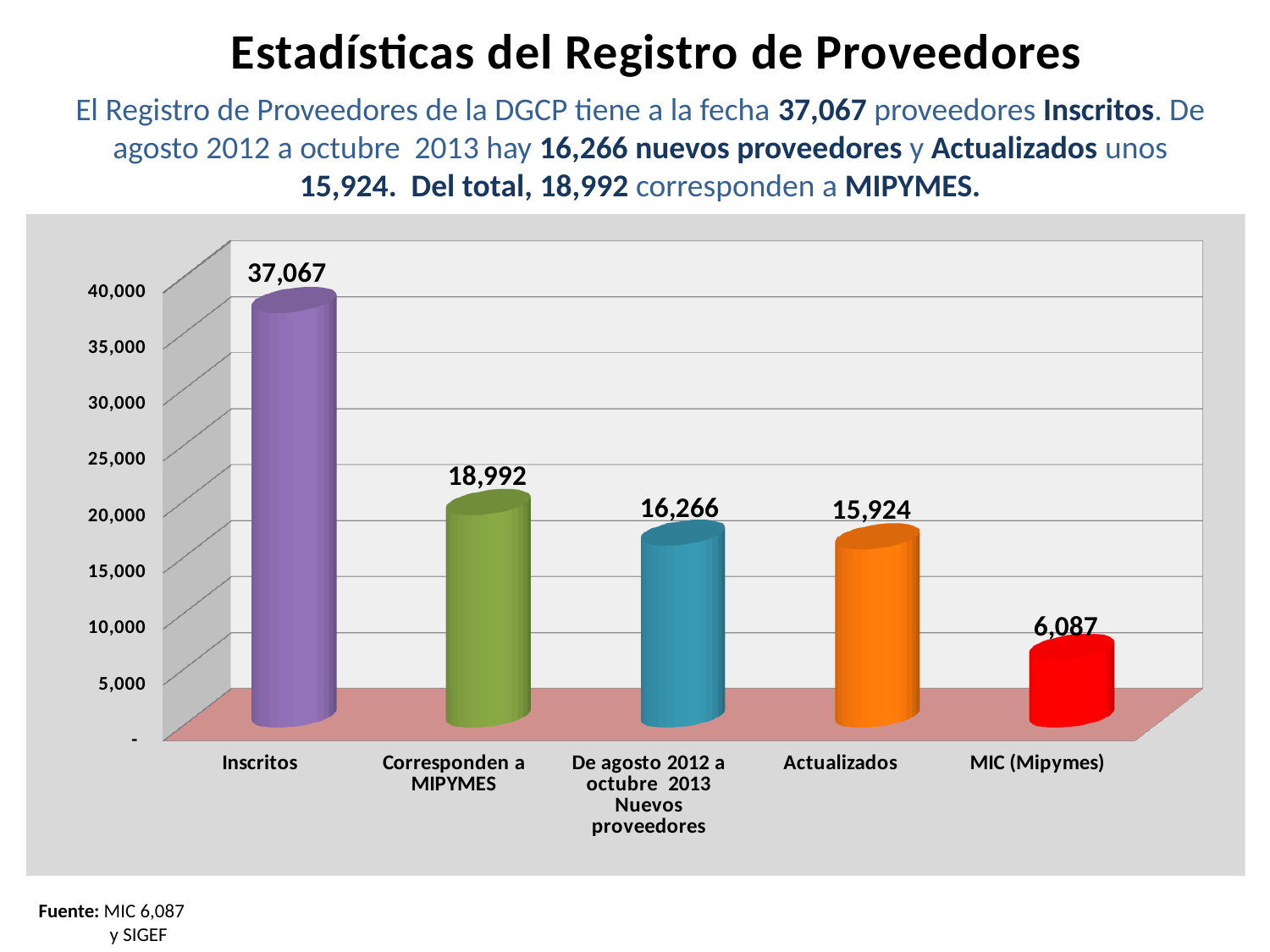
What kind of chart is shown on the slide? Bar chart How many categories are shown in the chart? 5 Which category has the lowest value? MIC (Mipymes) What is the value for Corresponden a MIPYMES? 18,992 What colour is the bar for Inscritos? Purple Which is larger, Corresponden a MIPYMES or Actualizados? Corresponden a MIPYMES What is the value for MIC (Mipymes)? 6,087 What is the difference between De agosto 2012 a octubre 2013 Nuevos proveedores and Actualizados? 342 What is the difference between Inscritos and Corresponden a MIPYMES? 18,075 What is the value for Actualizados? 15,924 Which category has the highest value? Inscritos What is the value for Inscritos? 37,067